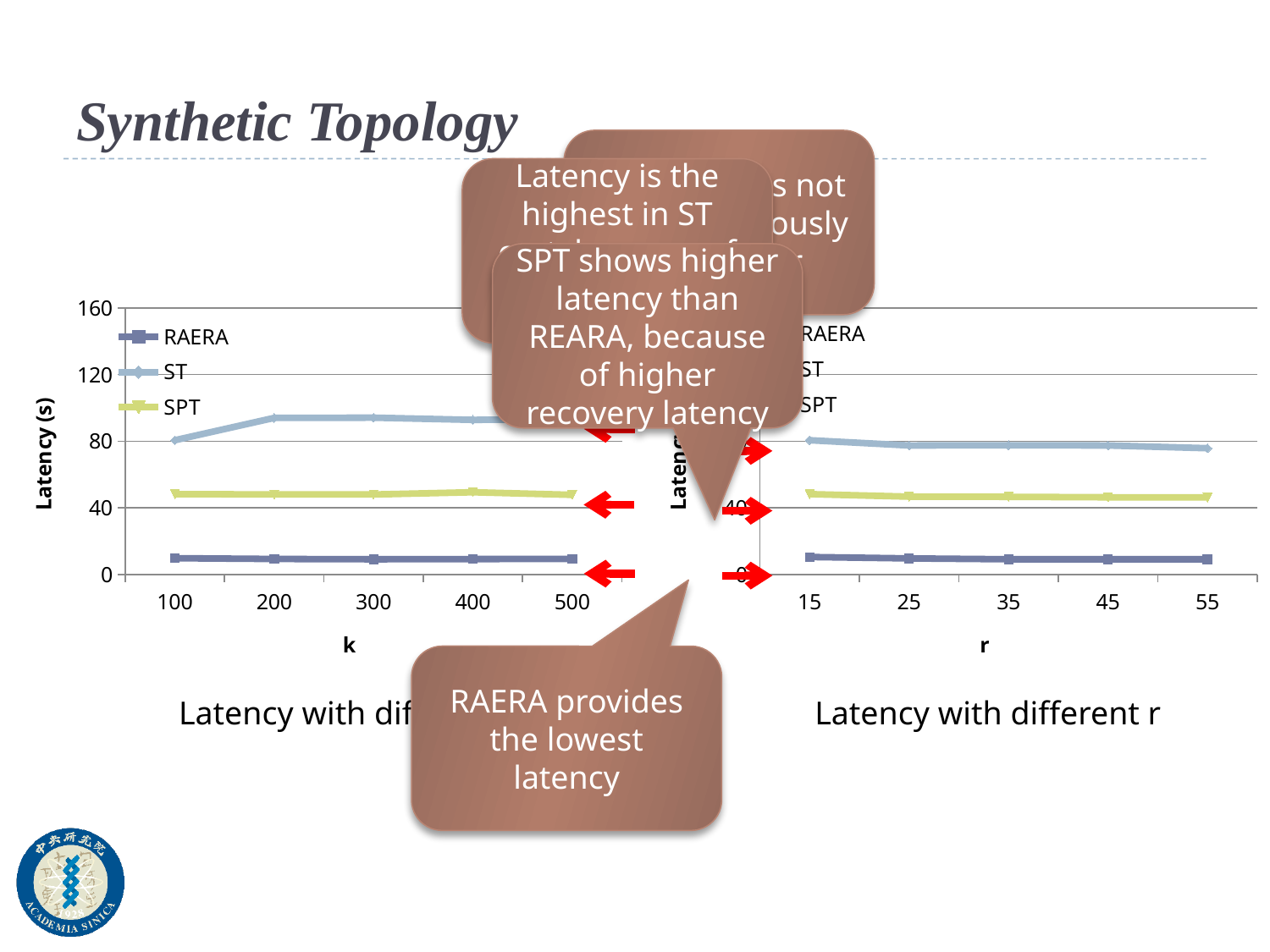
In the chart titled 'Latency with different r', which series is larger at r = 15, SPT or RAERA? SPT In the chart titled 'Latency with different r', which series has the lowest latency? RAERA How many r values are plotted along the x axis of the chart titled 'Latency with different r'? 5 In the left chart, which series has the highest latency? ST How many series does the legend of the chart titled 'Latency with different r' list? 3 In the chart titled 'Latency with different r', is the SPT value at r = 35 greater or less than 80? less In the chart titled 'Latency with different r', does the ST line rise or fall as r increases from 15 to 55? fall What is the y-axis title of the left chart? Latency (s) What kind of chart is the left chart on the slide? line chart In the left chart, is the RAERA value at k = 100 greater or less than 40? less How many k values are plotted along the x axis of the left chart? 5 In the left chart, is the ST value at k = 200 greater or less than 80? greater